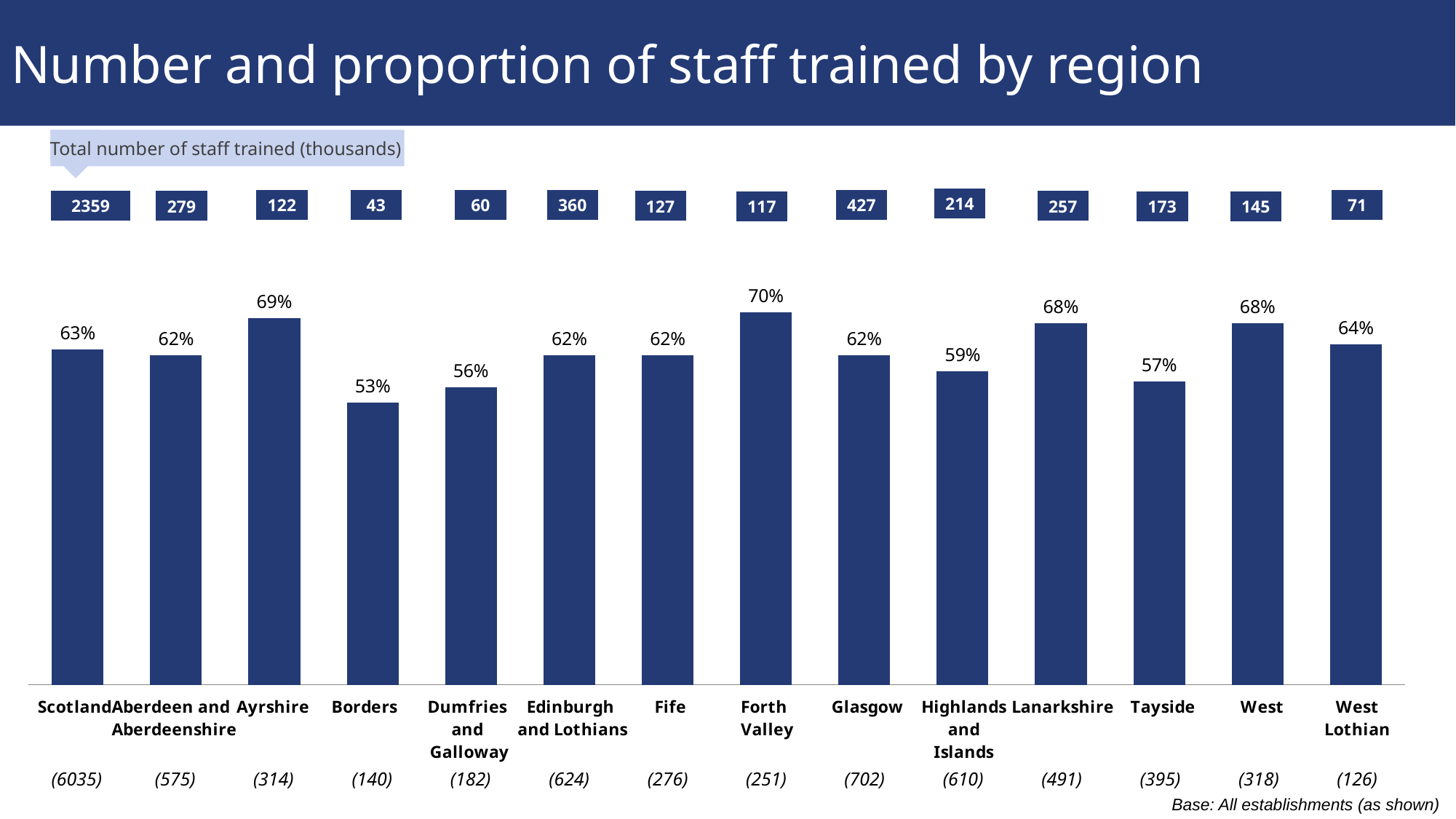
What is the base (number of establishments) shown for Edinburgh and Lothians? 624 Which region has the lowest proportion of staff trained? Borders Which has a higher proportion of staff trained, Highlands and Islands or West Lothian? West Lothian What proportion of staff were trained in Forth Valley? 70% Which region has the highest proportion of staff trained? Forth Valley What proportion of staff were trained in Borders? 53% What kind of chart is shown on the slide? Bar chart What is the title of the slide? Number and proportion of staff trained by region How many regions (including Scotland) are shown on the chart? 14 What is the total number of staff trained (thousands) shown for Scotland? 2359 What is the total number of staff trained (thousands) shown for Glasgow? 427 What is the difference in percentage points between the proportion of staff trained in Ayrshire and in Tayside? 12